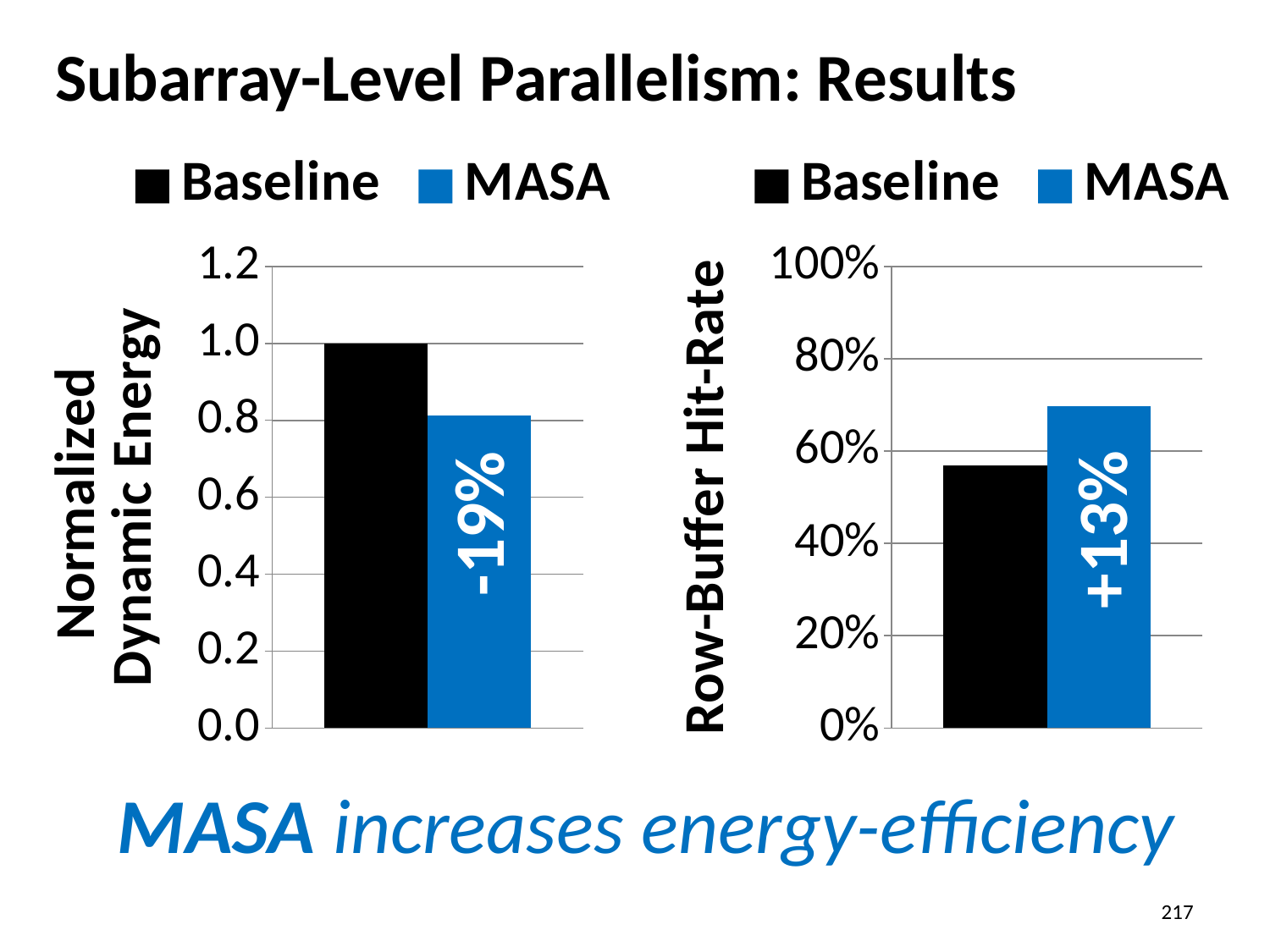
On the left chart (Normalized Dynamic Energy), which series has the lower value, Baseline or MASA? MASA On the right chart (Row-Buffer Hit-Rate), is the value for MASA greater or less than 80%? less On the right chart (Row-Buffer Hit-Rate), what percentage change is printed on the MASA bar? +13% On the left chart (Normalized Dynamic Energy), is the value for MASA greater or less than 1.0? less On the right chart (Row-Buffer Hit-Rate), is the value for MASA greater or less than 60%? greater On the right chart (Row-Buffer Hit-Rate), which series has the higher value, Baseline or MASA? MASA What kind of chart is the right chart (Row-Buffer Hit-Rate)? bar chart How many series does the legend of the left chart list? 2 On the left chart (Normalized Dynamic Energy), what is the value for Baseline? 1.0 On the left chart (Normalized Dynamic Energy), is the Baseline value larger or smaller than the MASA value? larger On the left chart (Normalized Dynamic Energy), what percentage change is printed on the MASA bar? -19%